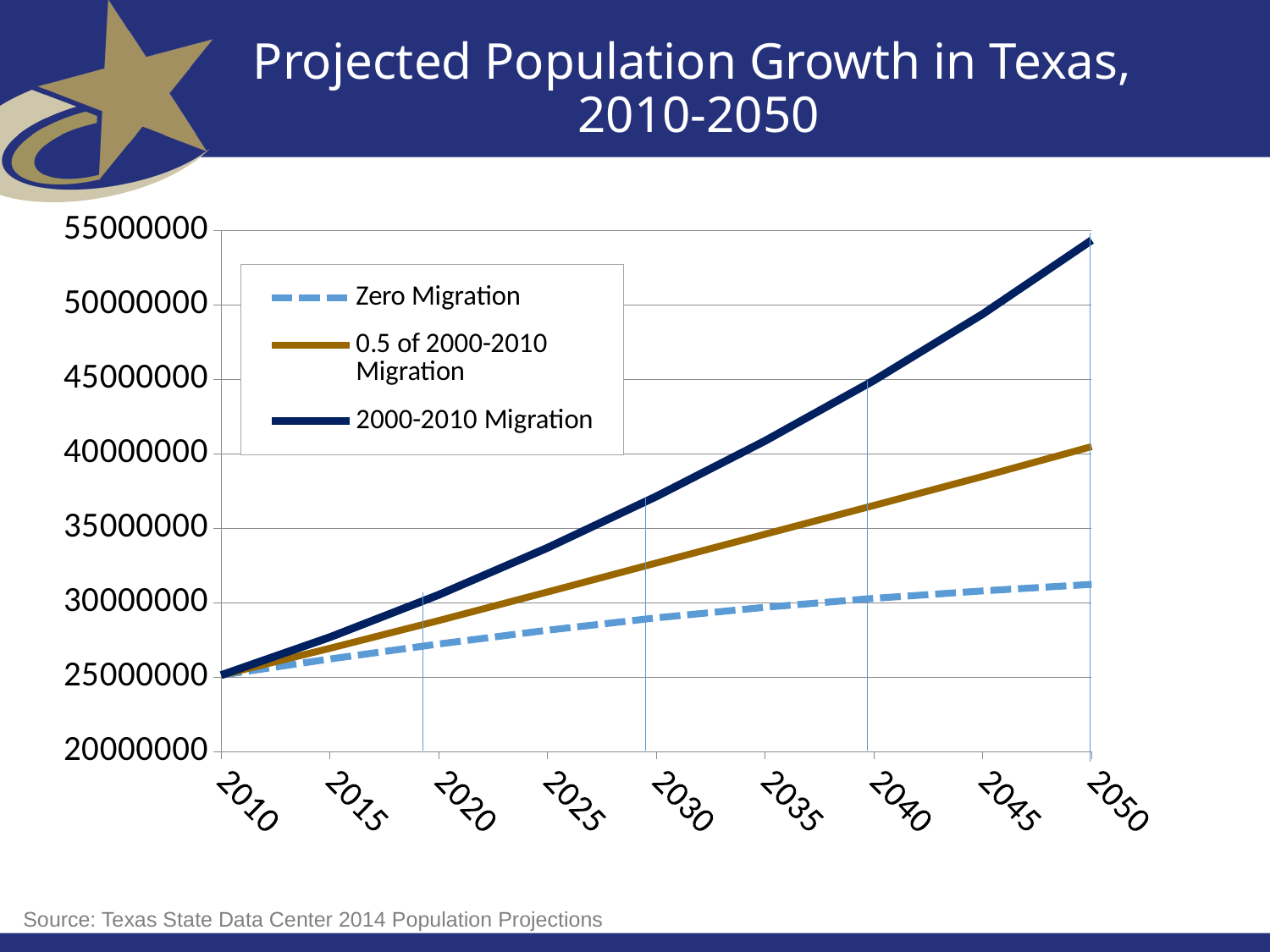
Which series has the highest value in 2050? 2000-2010 Migration Is the value for Zero Migration in 2050 greater or less than 35000000? less Does the Zero Migration line rise or fall from 2010 to 2050? rise Is the value for 2000-2010 Migration in 2040 greater or less than 40000000? greater Which series has the lowest value in 2050? Zero Migration Is the value for 2000-2010 Migration in 2050 greater or less than 50000000? greater In 2050, which is larger: the value for 2000-2010 Migration or the value for Zero Migration? 2000-2010 Migration Does the 2000-2010 Migration line rise or fall from 2010 to 2050? rise What is the title of the chart? Projected Population Growth in Texas, 2010-2050 How many years are labelled along the x axis? 9 How many series does the legend list? 3 What kind of chart is shown on the slide? line chart